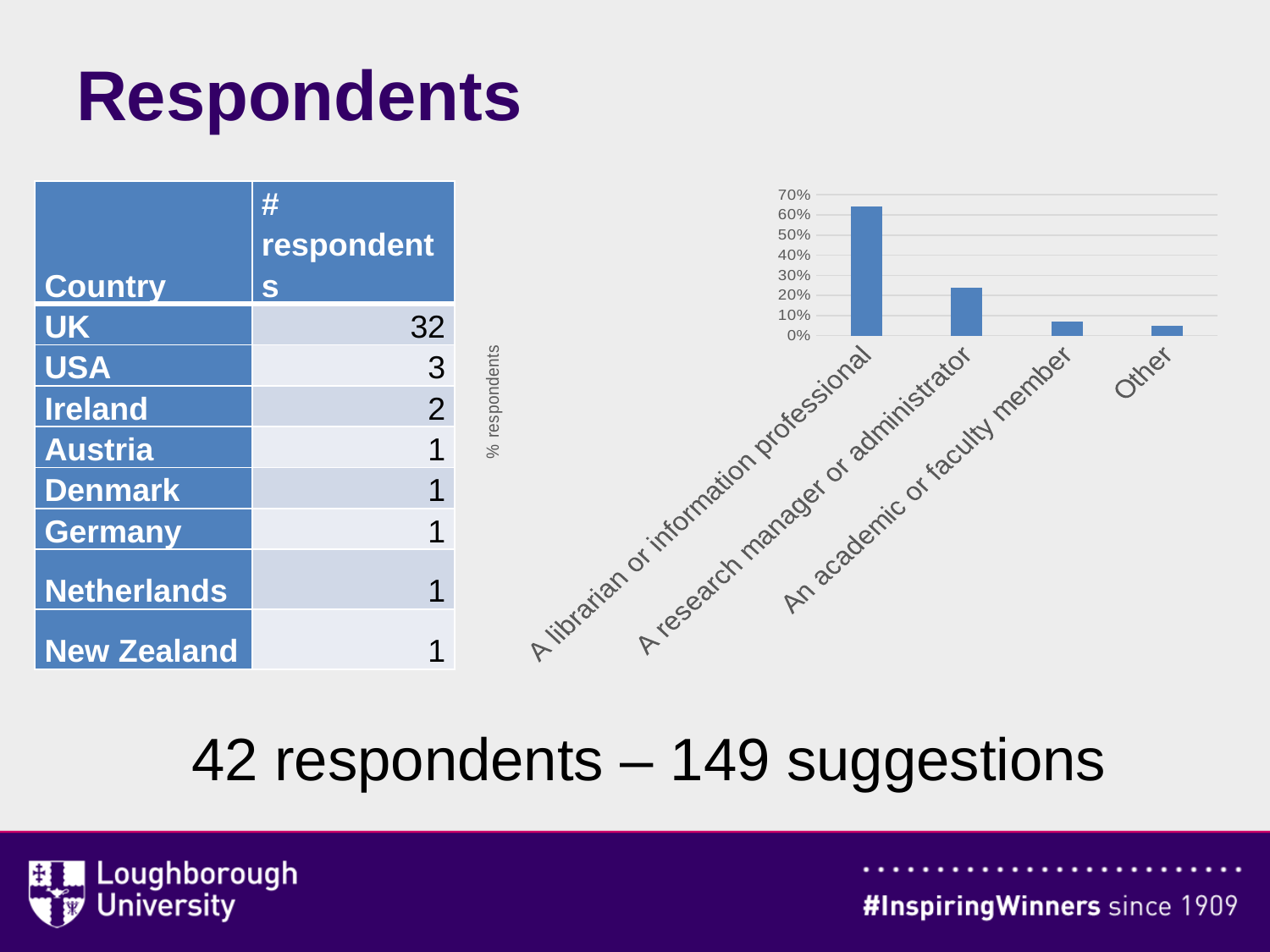
Which category has the lowest value on the bar chart? Other How many categories are plotted on the bar chart? 4 Is the value for A research manager or administrator greater or less than 30%? less What is the label on the vertical axis of the bar chart? % respondents Do the values on the bar chart rise or fall from left to right along the x axis? fall Is the value for Other greater or less than 10%? less Which category has the highest value on the bar chart? A librarian or information professional What kind of chart is shown on the slide? bar chart Is the value for An academic or faculty member greater or less than 10%? less What is the highest tick value shown on the vertical axis of the bar chart? 70% Which is larger on the bar chart: A research manager or administrator or An academic or faculty member? A research manager or administrator